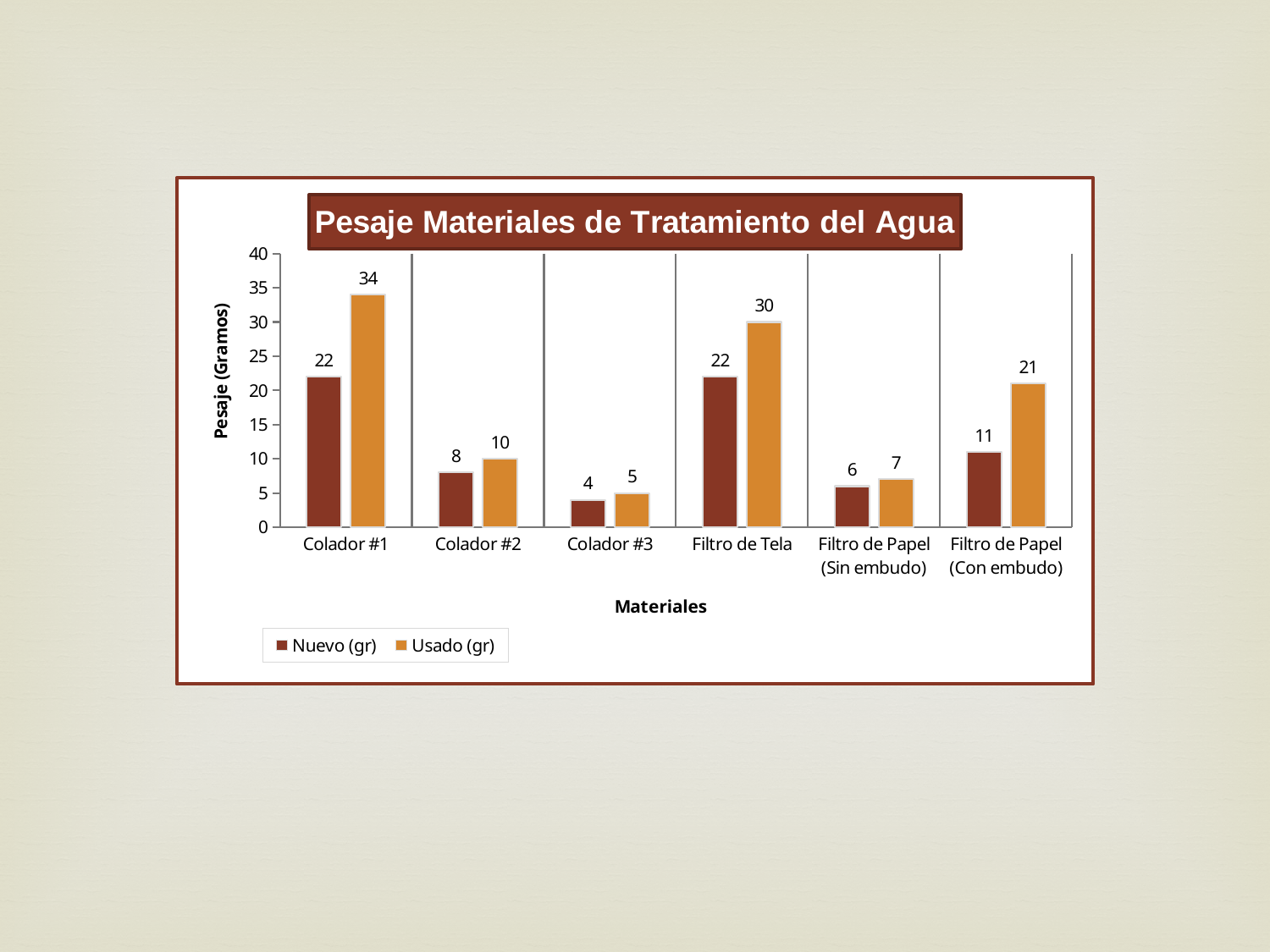
What is the Usado (gr) value for Filtro de Tela? 30 How many series does the legend list? 2 What kind of chart is shown on the slide? Bar chart What is the difference between the Usado (gr) values for Filtro de Tela and Filtro de Papel (Con embudo)? 9 Which material has the highest Usado (gr) value? Colador #1 How many materials are shown on the x axis? 6 What is the Usado (gr) value for Filtro de Papel (Con embudo)? 21 What is the Nuevo (gr) value for Colador #1? 22 What is the difference between the Usado (gr) and Nuevo (gr) values for Colador #1? 12 Which material has the lowest Nuevo (gr) value? Colador #3 What is the title of the chart? Pesaje Materiales de Tratamiento del Agua Which is larger, the Nuevo (gr) value for Colador #2 or the Nuevo (gr) value for Filtro de Papel (Con embudo)? Filtro de Papel (Con embudo)